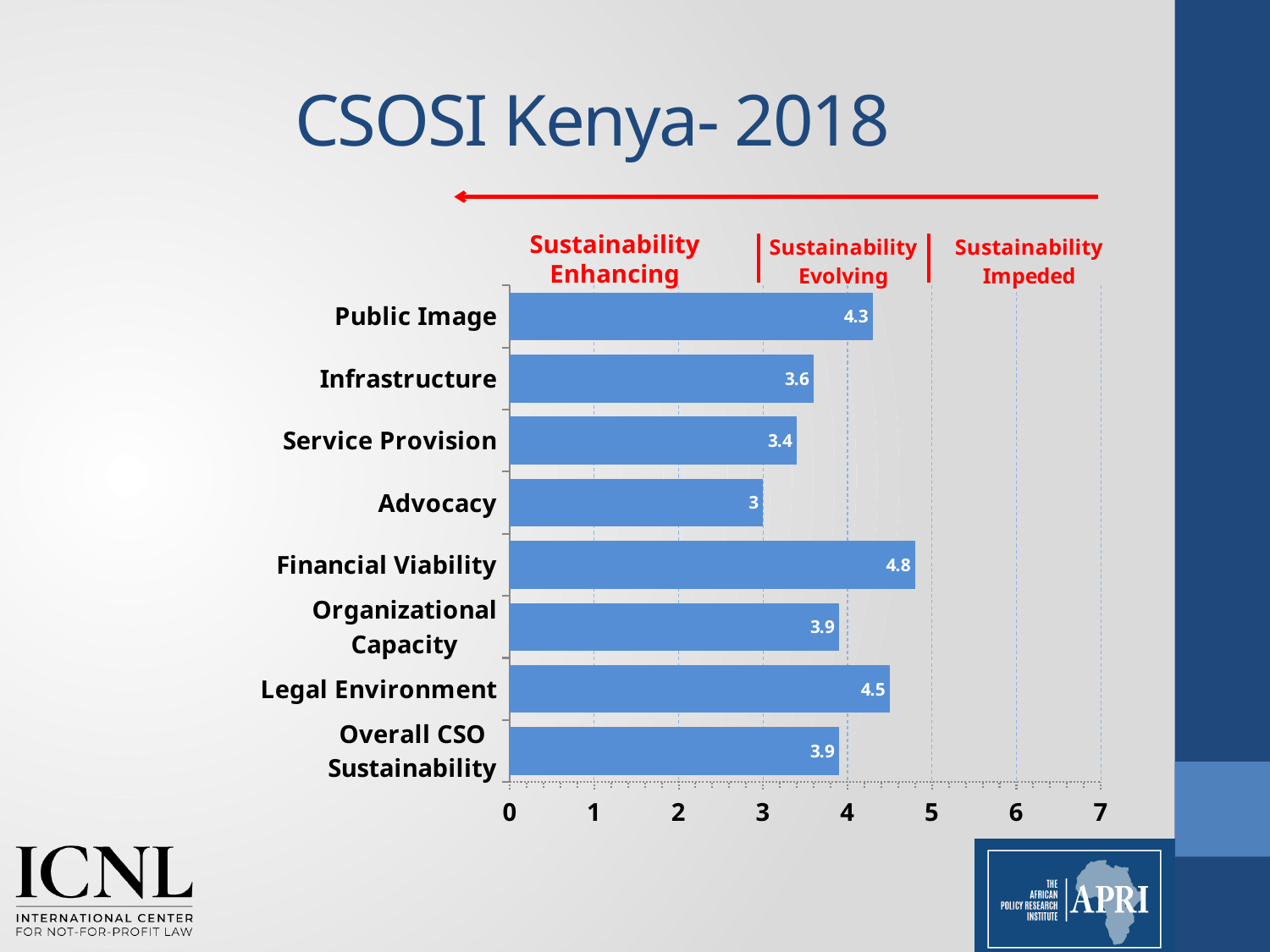
What kind of chart is shown on the slide? bar chart How many categories are shown in the chart? 8 What is the value for Public Image? 4.3 Which category has the highest value? Financial Viability What is the difference between the values for Legal Environment and Service Provision? 1.1 What is the value for Advocacy? 3 What is the title of the slide? CSOSI Kenya- 2018 What is the value for Financial Viability? 4.8 Which category has the lowest value? Advocacy Which is larger, the value for Infrastructure or the value for Organizational Capacity? Organizational Capacity What is the value for Overall CSO Sustainability? 3.9 Is the value for Legal Environment greater or less than 4? greater